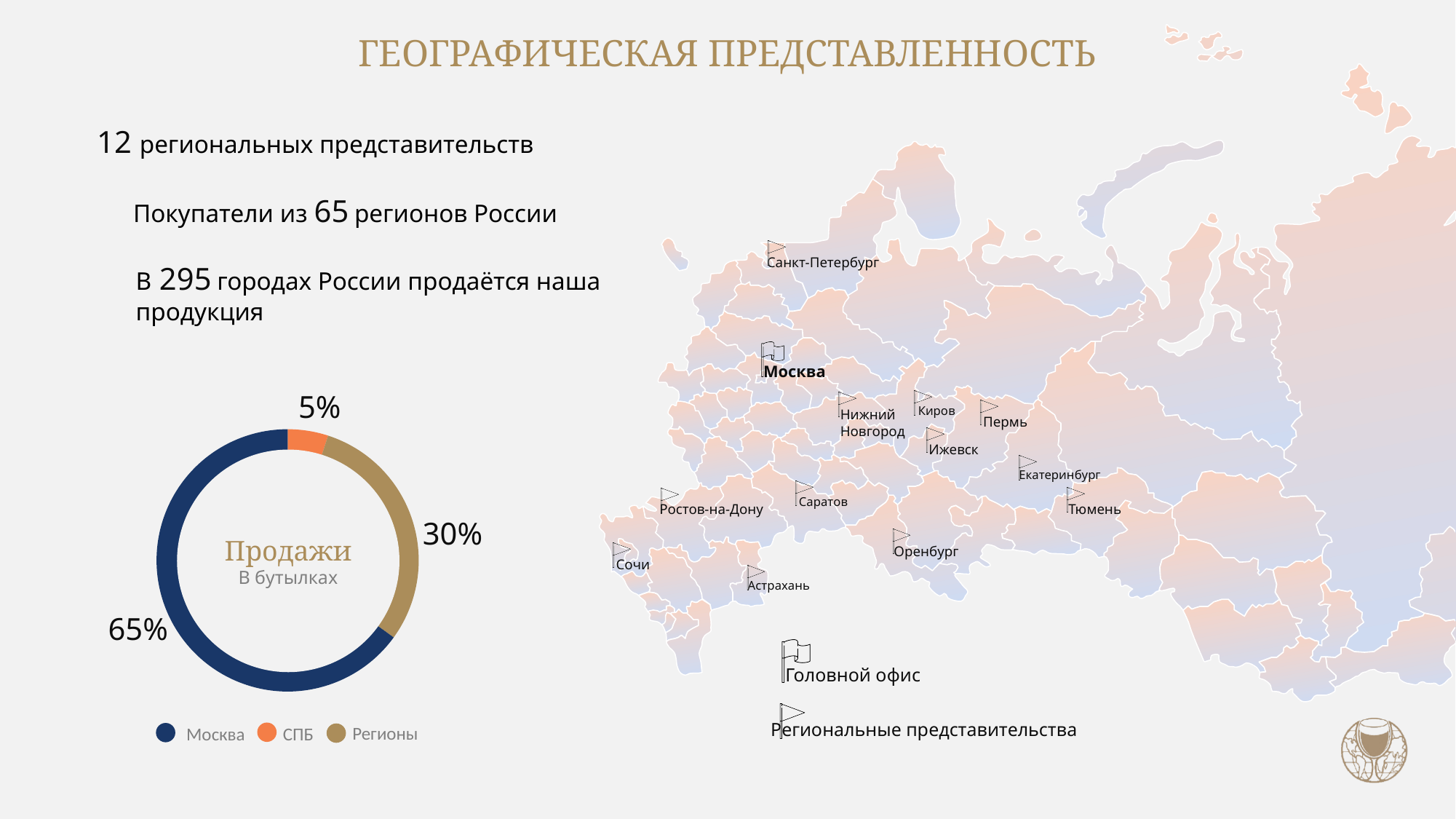
In the Продажи donut chart, how many percentage points larger is the share of Регионы than the share of СПБ? 25% Which category has the largest share in the Продажи donut chart? Москва What share of sales does СПБ account for in the Продажи donut chart? 5% What share of sales do Регионы account for in the Продажи donut chart? 30% What share of sales does Москва account for in the Продажи donut chart? 65% Which colour represents СПБ in the Продажи donut chart legend? Orange How many categories are shown in the Продажи donut chart? 3 What kind of chart is used to show Продажи on the slide? Donut (pie) chart Which category has the smallest share in the Продажи donut chart? СПБ What unit is stated under the title in the centre of the Продажи donut chart? В бутылках In the Продажи donut chart, which is larger: the share of Регионы or the share of СПБ? Регионы In the Продажи donut chart, how many percentage points larger is the share of Москва than the share of Регионы? 35%